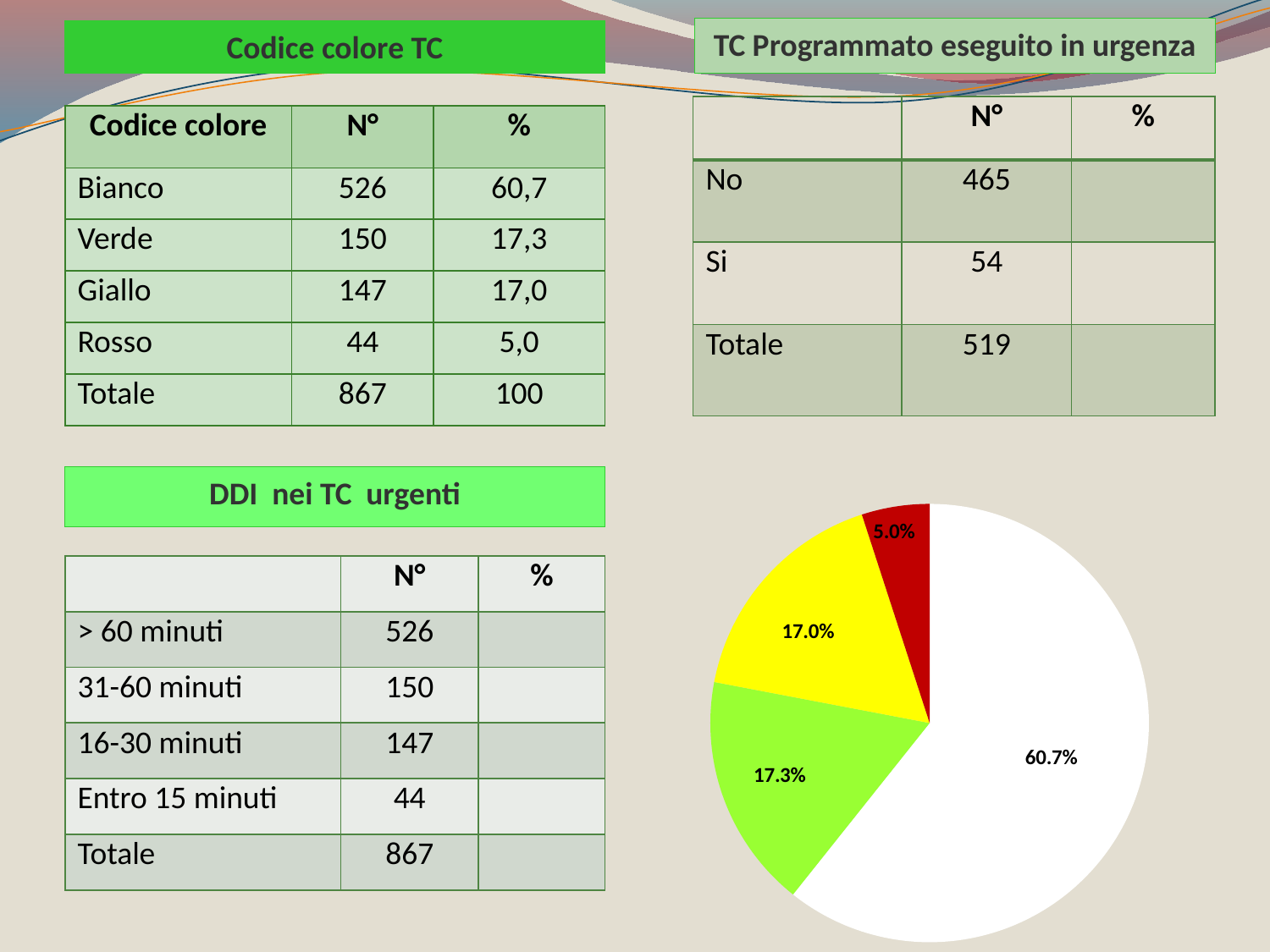
How many slices does the pie chart have? 4 In the pie chart, is the white slice or the yellow slice larger? the white slice What kind of chart is shown on the slide? pie chart In the pie chart, what is the difference between the yellow slice and the red slice? 12.0% What percentage is labelled on the green slice of the pie chart? 17.3% Does the pie chart have a legend? No Which slice of the pie chart is the largest? the white slice (60.7%) In the pie chart, what is the difference between the white slice and the green slice? 43.4% Which slice of the pie chart is the smallest? the red slice (5.0%) What percentage is labelled on the white slice of the pie chart? 60.7% What percentage is labelled on the red slice of the pie chart? 5.0% What percentage is labelled on the yellow slice of the pie chart? 17.0%